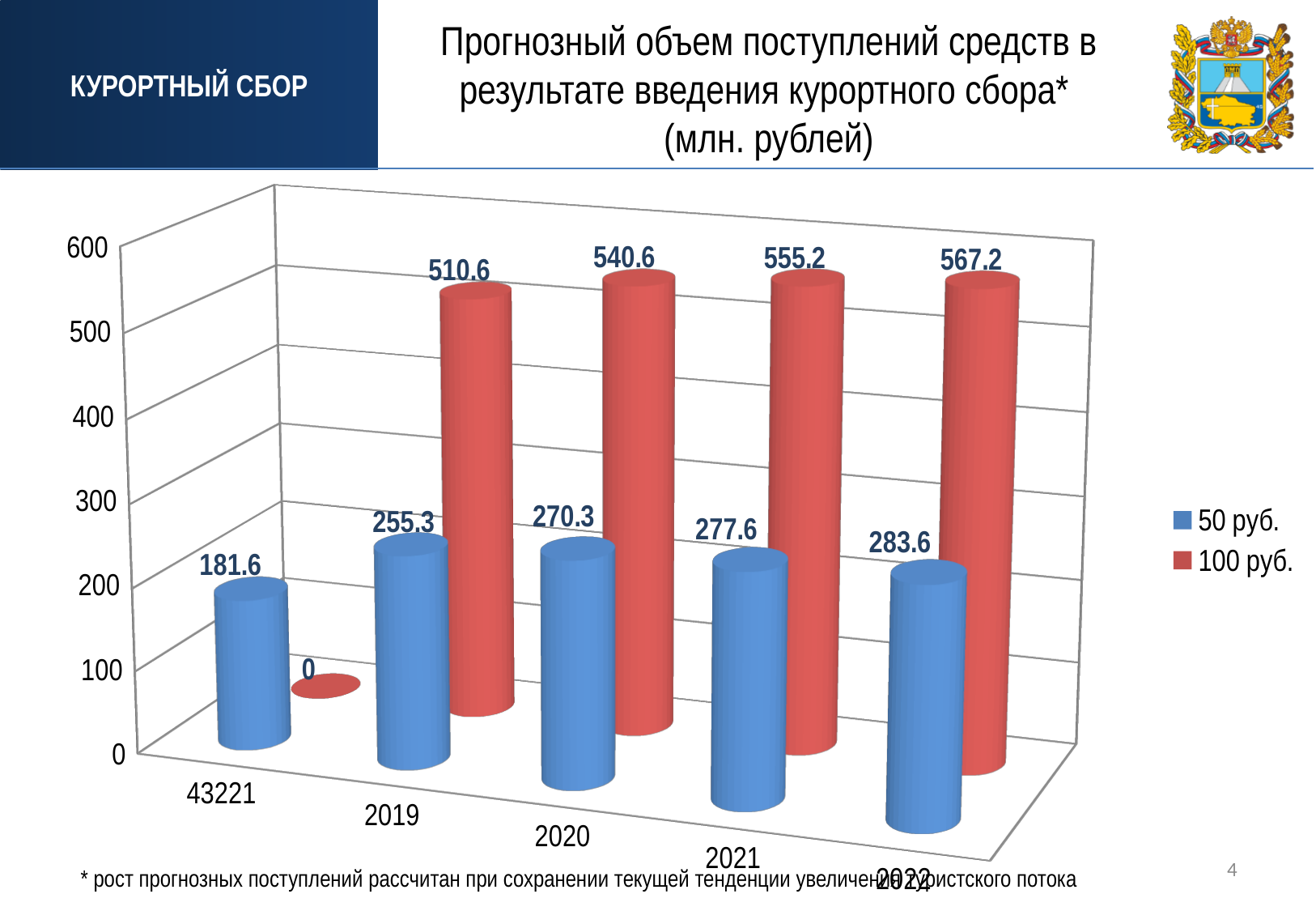
How many series does the legend list? 2 What is the value for the 50 руб. series in 2020? 270.3 What kind of chart is shown on the slide? Bar chart In which year is the 100 руб. series highest? 2022 What is the value for the 50 руб. series in 2019? 255.3 Which category has the lowest value for the 50 руб. series? 43221 What is the value for the 100 руб. series in 2022? 567.2 How many categories are shown on the x axis? 5 Do the values of the 50 руб. series rise or fall from the first category to 2022? Rise What is the value for the 100 руб. series in the first category (labelled 43221)? 0 Which is larger in 2020: the 50 руб. value or the 100 руб. value? 100 руб. What is the difference between the 100 руб. and 50 руб. values in 2021? 277.6